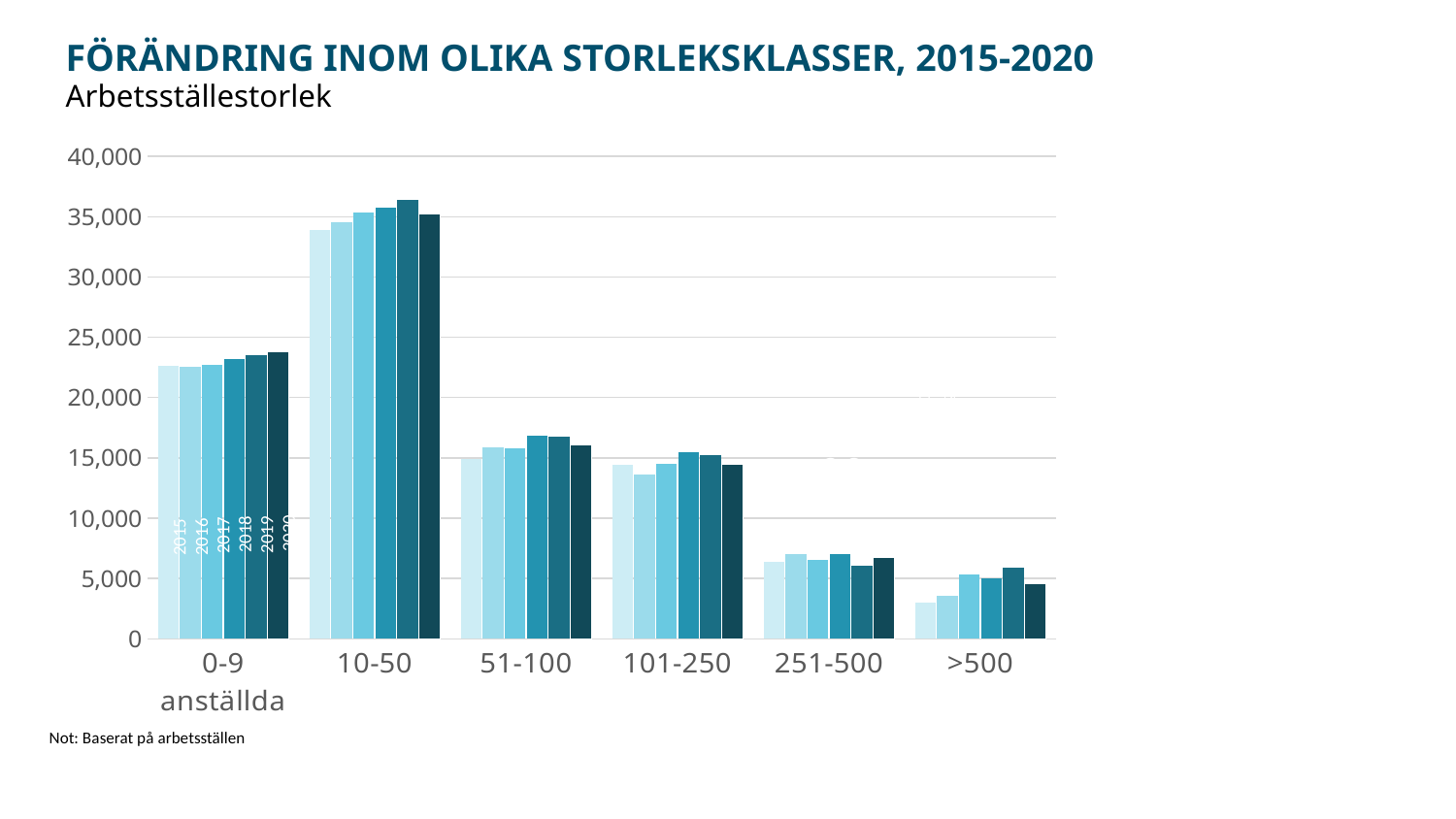
Which size category has the highest values? 10-50 Is the value for the 251-500 category in 2019 greater or less than 10,000? less How many size categories (arbetsställestorlek) are shown on the x axis? 6 Which category has larger values, 0-9 or 10-50? 10-50 Do the values for the 0-9 category rise or fall from 2015 to 2020? rise Is the value for the >500 category in 2015 greater or less than 5,000? less Is the value for the 0-9 category in 2020 greater or less than 20,000? greater What kind of chart is shown on the slide? bar chart What is the title of the chart? FÖRÄNDRING INOM OLIKA STORLEKSKLASSER, 2015-2020 Which size category has the lowest values? >500 How many years (series) are plotted for each size category? 6